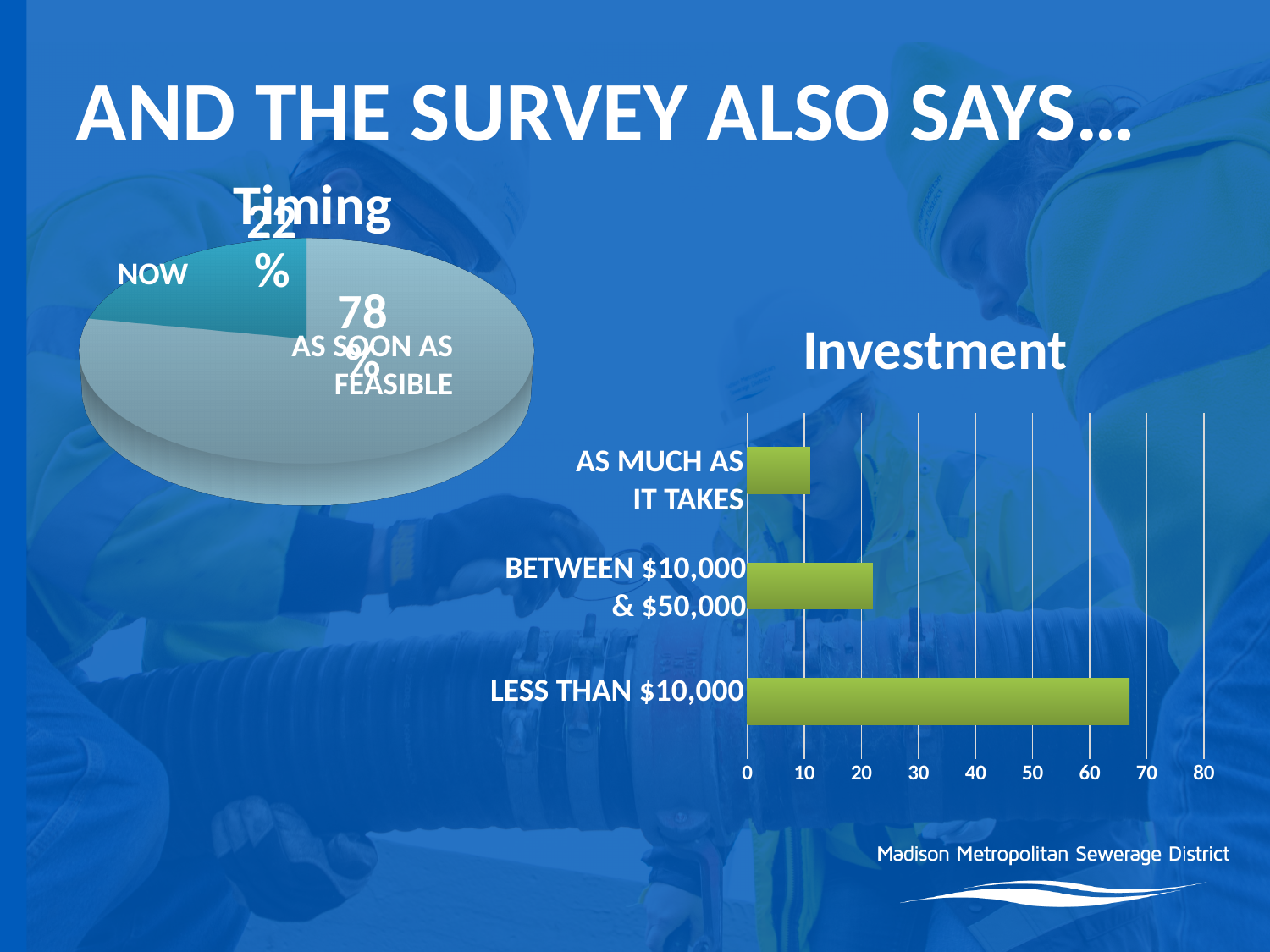
In the Timing pie chart, which slice is larger, NOW or AS SOON AS FEASIBLE? AS SOON AS FEASIBLE How many categories does the Investment bar chart show? 3 In the Investment bar chart, which category has the lowest value? AS MUCH AS IT TAKES What kind of chart is the Investment chart? Bar chart In the Timing pie chart, what percentage is shown for AS SOON AS FEASIBLE? 78% In the Investment bar chart, is the value for LESS THAN $10,000 greater or less than 60? greater In the Investment bar chart, which category has the highest value? LESS THAN $10,000 In the Timing pie chart, what percentage is shown for NOW? 22% What kind of chart is the Timing chart? Pie chart In the Timing pie chart, what is the difference in percentage points between AS SOON AS FEASIBLE and NOW? 56 In the Investment bar chart, is the value for AS MUCH AS IT TAKES greater or less than 20? less How many slices does the Timing pie chart have? 2